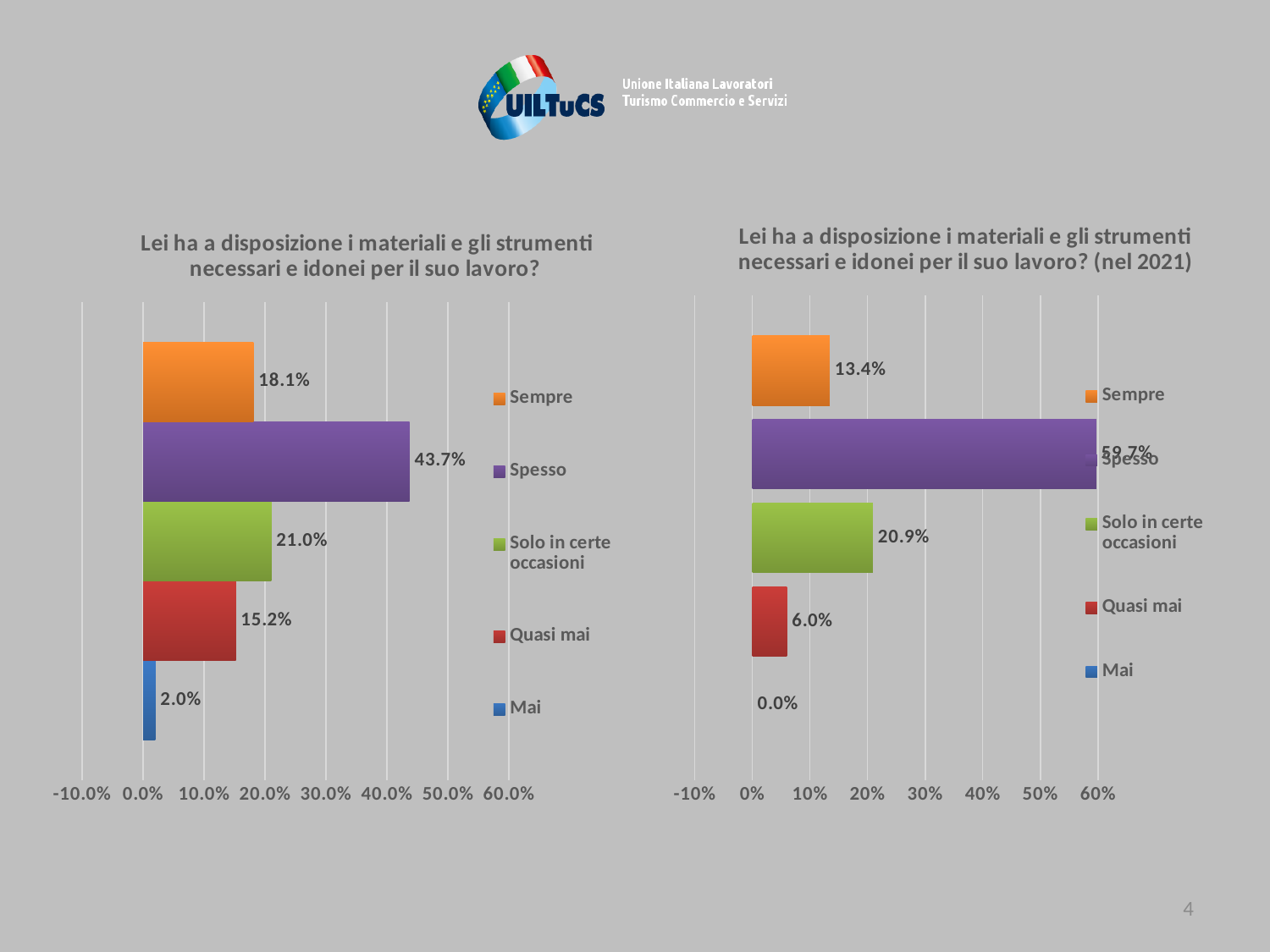
In the left chart, what is the difference between Spesso and Sempre? 25.6% In the left chart, what is the value for Quasi mai? 15.2% In the right chart (nel 2021), what is the difference between Solo in certe occasioni and Quasi mai? 14.9% What type of chart is the left chart? Bar chart In the right chart (nel 2021), which category has the lowest value? Mai In the left chart, what colour is the bar for Mai? Blue In the right chart (nel 2021), what is the value for Mai? 0.0% In the right chart (nel 2021), what is the value for Sempre? 13.4% In the left chart, which category has the highest value? Spesso In the left chart, what is the value for Spesso? 43.7% How many categories does the legend of the right chart list? 5 In the left chart, which is larger: Solo in certe occasioni or Sempre? Solo in certe occasioni